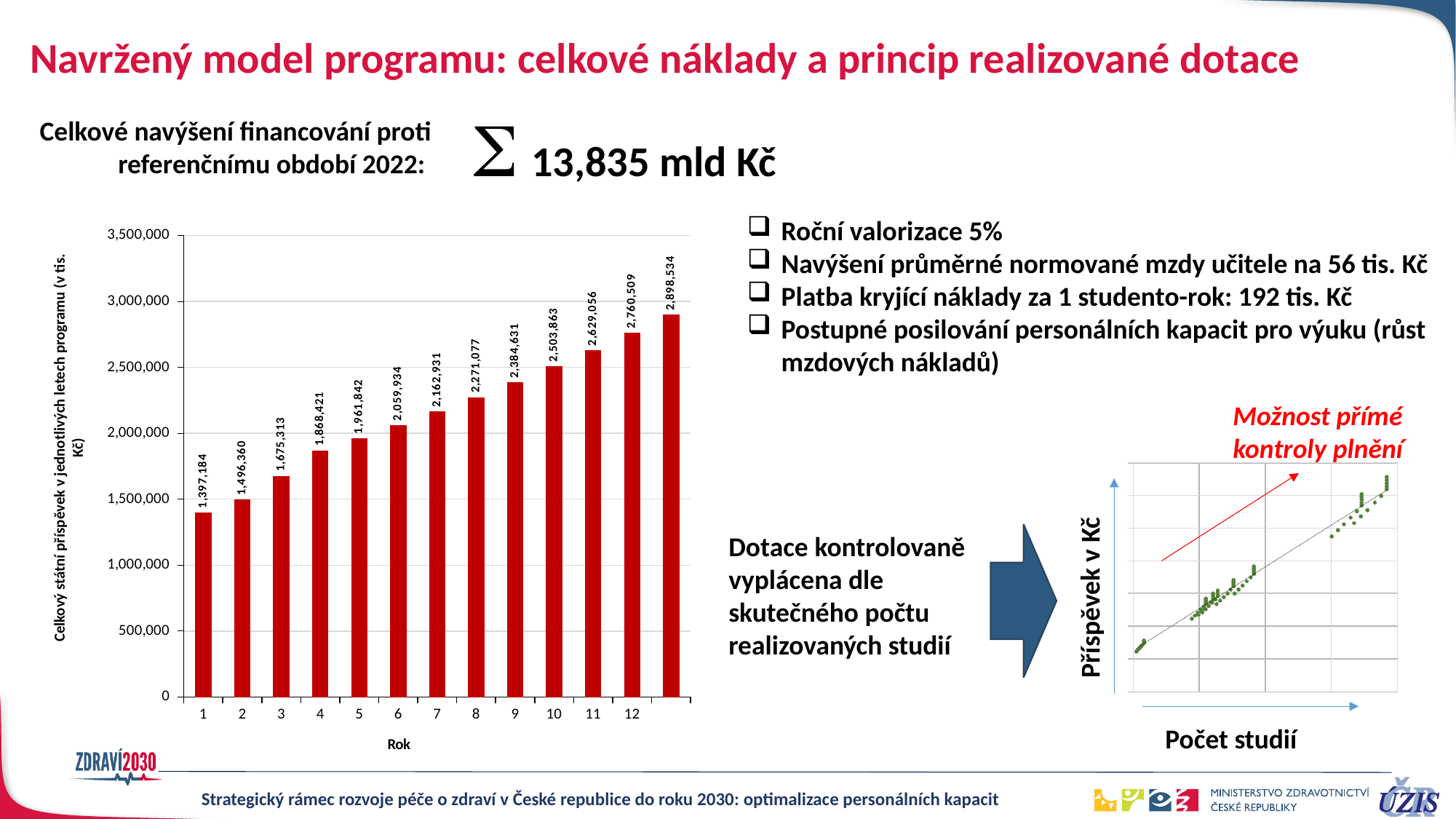
On the bar chart on the left, what is the value for year (Rok) 5? 1,961,842 On the bar chart on the left, what is the value for year (Rok) 10? 2,503,863 What is the x-axis label of the scatter chart on the right of the slide? Počet studií On the bar chart on the left, what is the difference between the values for year 12 and year 1? 1,363,325 On the bar chart on the left, do the values rise or fall as the year (Rok) increases? Rise On the bar chart on the left, which is larger: the value for year 3 or the value for year 7? Year 7 On the bar chart on the left, is the value for year 8 greater or less than 2,000,000? greater How many bars are plotted on the bar chart on the left? 13 On the bar chart on the left, which year (Rok) has the lowest value? 1 What kind of chart is the chart on the left of the slide? Bar chart On the bar chart on the left, what is the value for year (Rok) 1? 1,397,184 On the bar chart on the left, what is the value of the tallest bar? 2,898,534